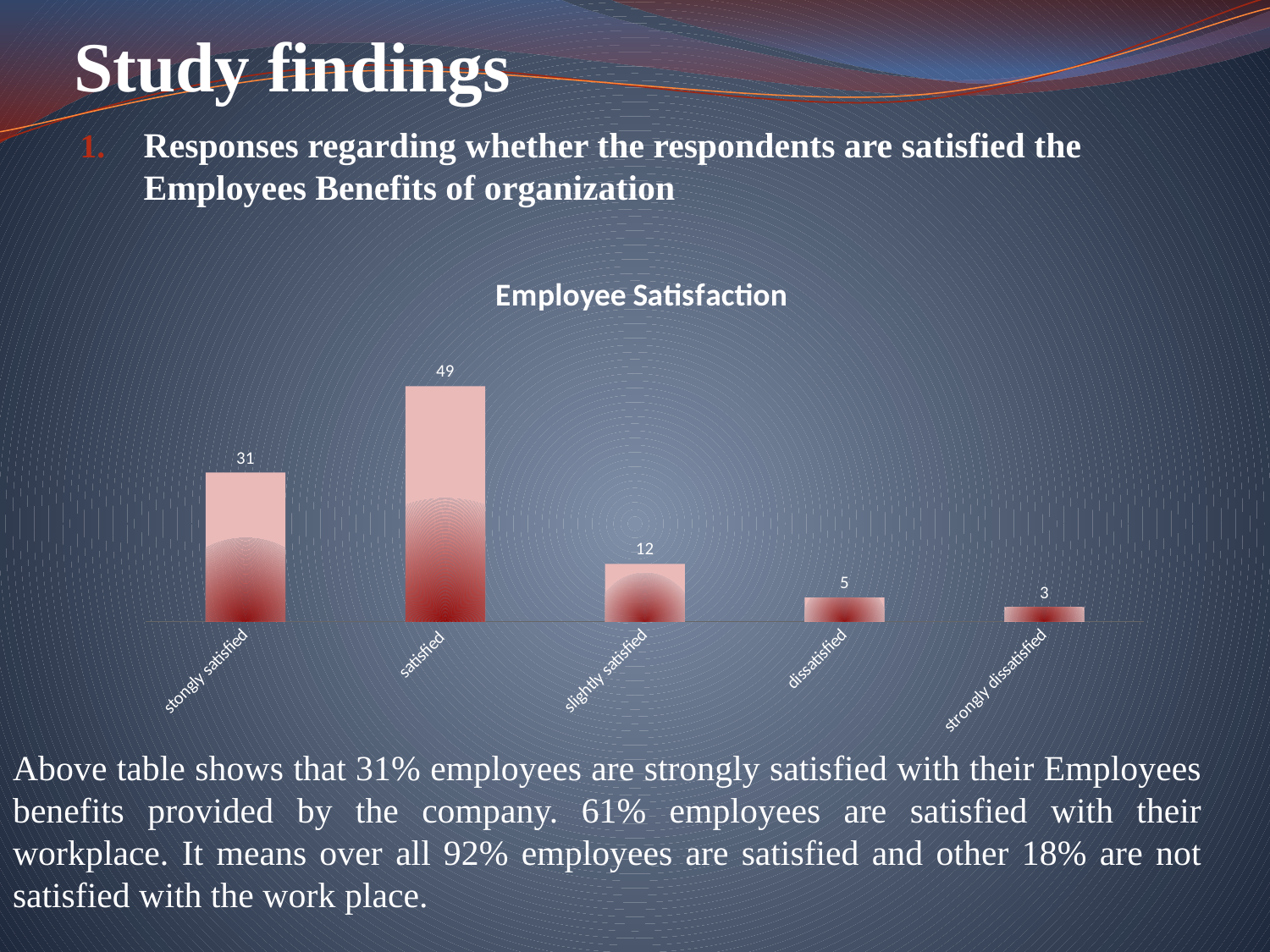
How many categories are shown on the x axis? 5 What is the value for 'strongly dissatisfied'? 3 What is the value for 'slightly satisfied'? 12 What is the value for 'strongly satisfied'? 31 Which category has the highest value? satisfied What is the difference between the values for 'satisfied' and 'strongly satisfied'? 18 Which is larger, the value for 'dissatisfied' or the value for 'slightly satisfied'? slightly satisfied What is the title of the chart? Employee Satisfaction Which category has the lowest value? strongly dissatisfied What kind of chart is shown? bar chart Do the values rise or fall from left to right after the 'satisfied' category? fall What is the value for the 'satisfied' category? 49